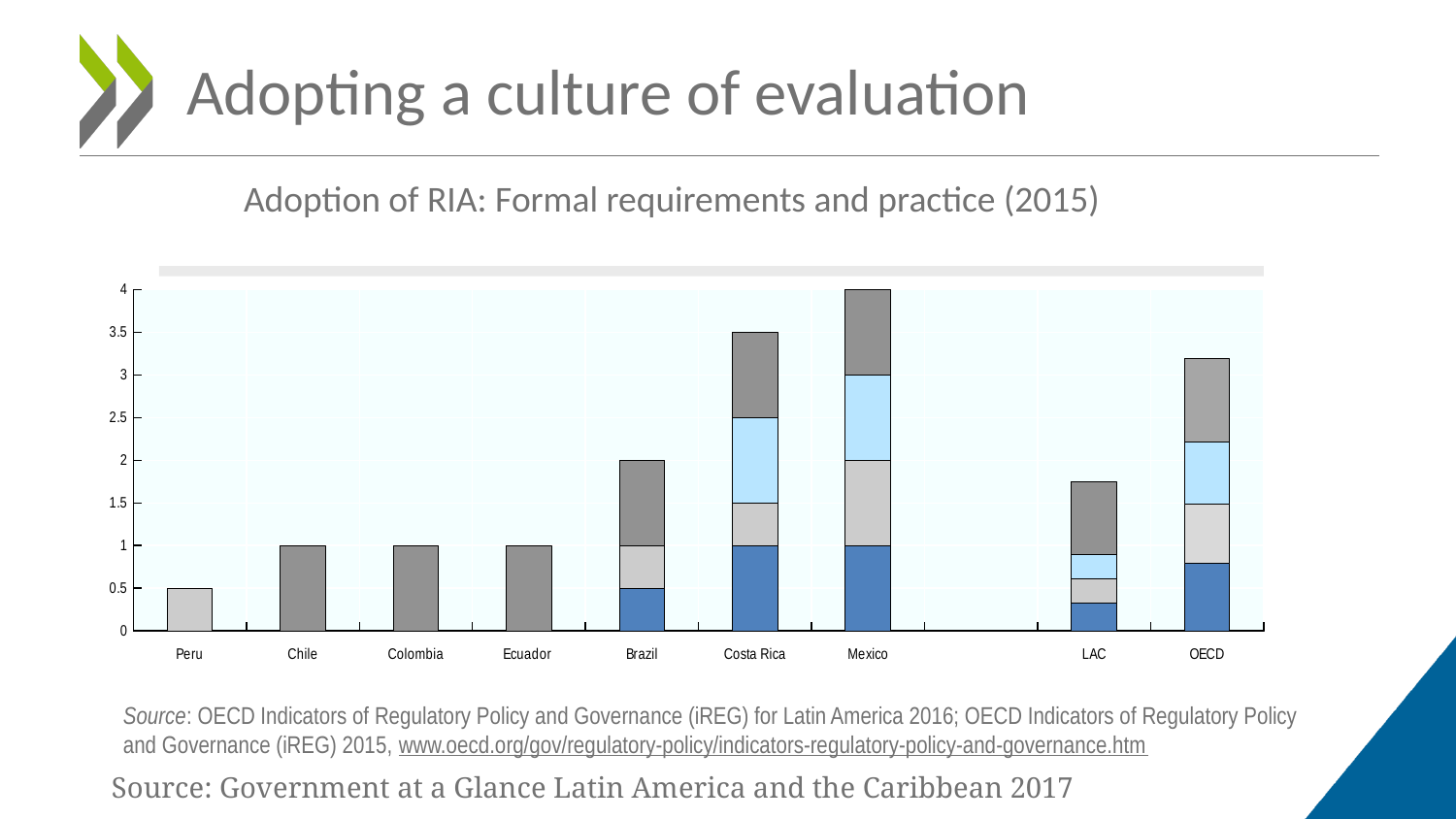
What is the total height of the bar for Mexico? 4 What is the total height of the bar for Brazil? 2 Which bar is taller, Costa Rica or Brazil? Costa Rica What is the difference between the total bar heights for Mexico and Brazil? 2 What is the title of the chart? Adoption of RIA: Formal requirements and practice (2015) Which category has the shortest bar in the chart? Peru What is the total height of the bar for Costa Rica? 3.5 Is the total value for LAC greater or less than 1.5? greater What is the value of the bar for Peru? 0.5 What kind of chart is shown on the slide? Stacked bar chart Which category has the tallest bar in the chart? Mexico How many categories are shown along the x axis of the chart? 9